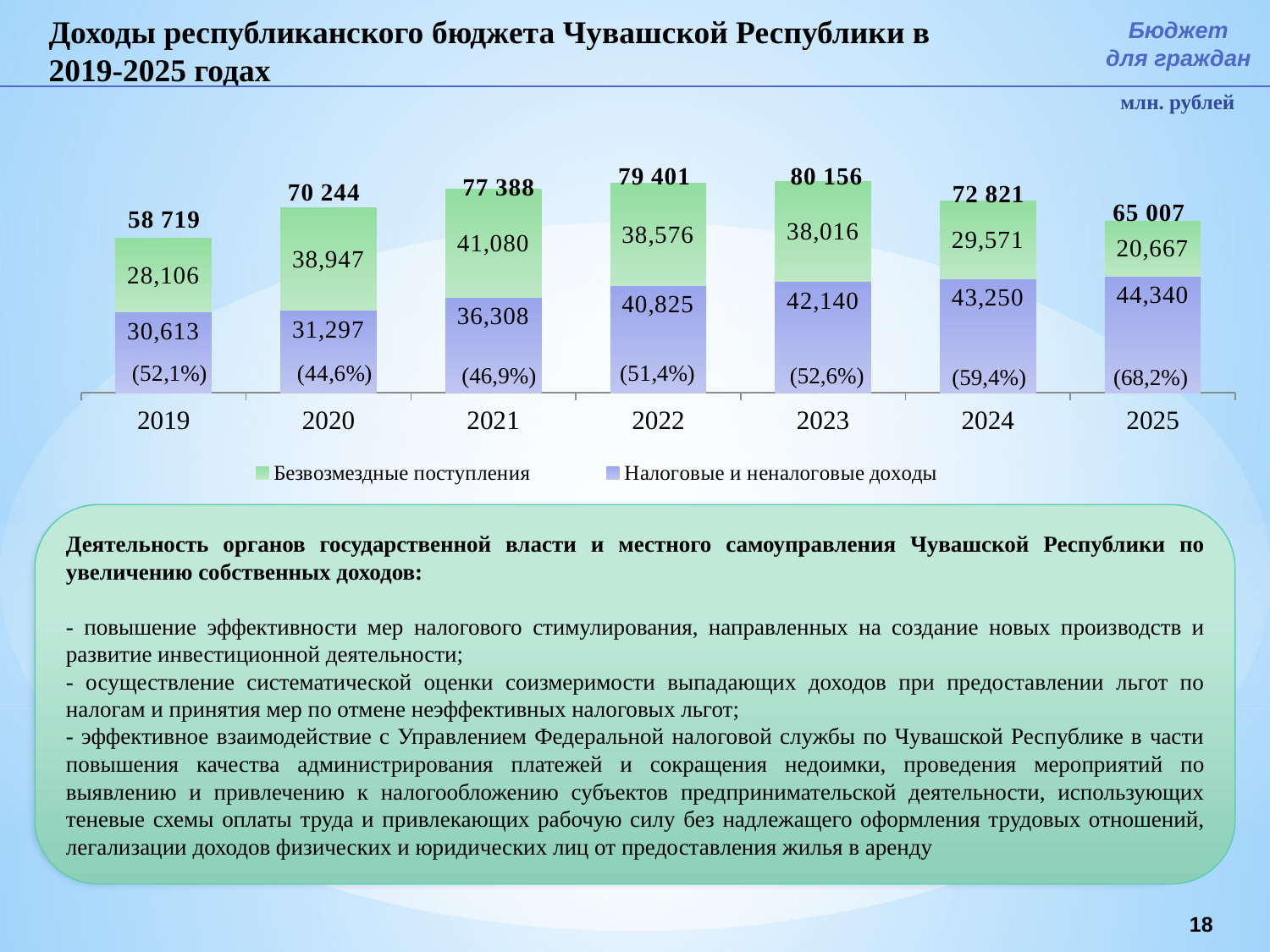
Do the values of Налоговые и неналоговые доходы rise or fall from 2019 to 2025? Rise What kind of chart is shown on the slide? Stacked bar chart What is the total revenue shown above the bar for 2024? 72 821 Which year has the lowest total revenue? 2019 What is the difference between Налоговые и неналоговые доходы in 2025 and in 2019? 13,727 How many series does the legend list? 2 Which year has the highest total revenue? 2023 What is the value of Безвозмездные поступления for 2021? 41,080 What is the value of Налоговые и неналоговые доходы for 2022? 40,825 Which is larger in 2020: Безвозмездные поступления or Налоговые и неналоговые доходы? Безвозмездные поступления How many years are shown on the x axis? 7 What percentage is shown in parentheses for 2025? (68,2%)